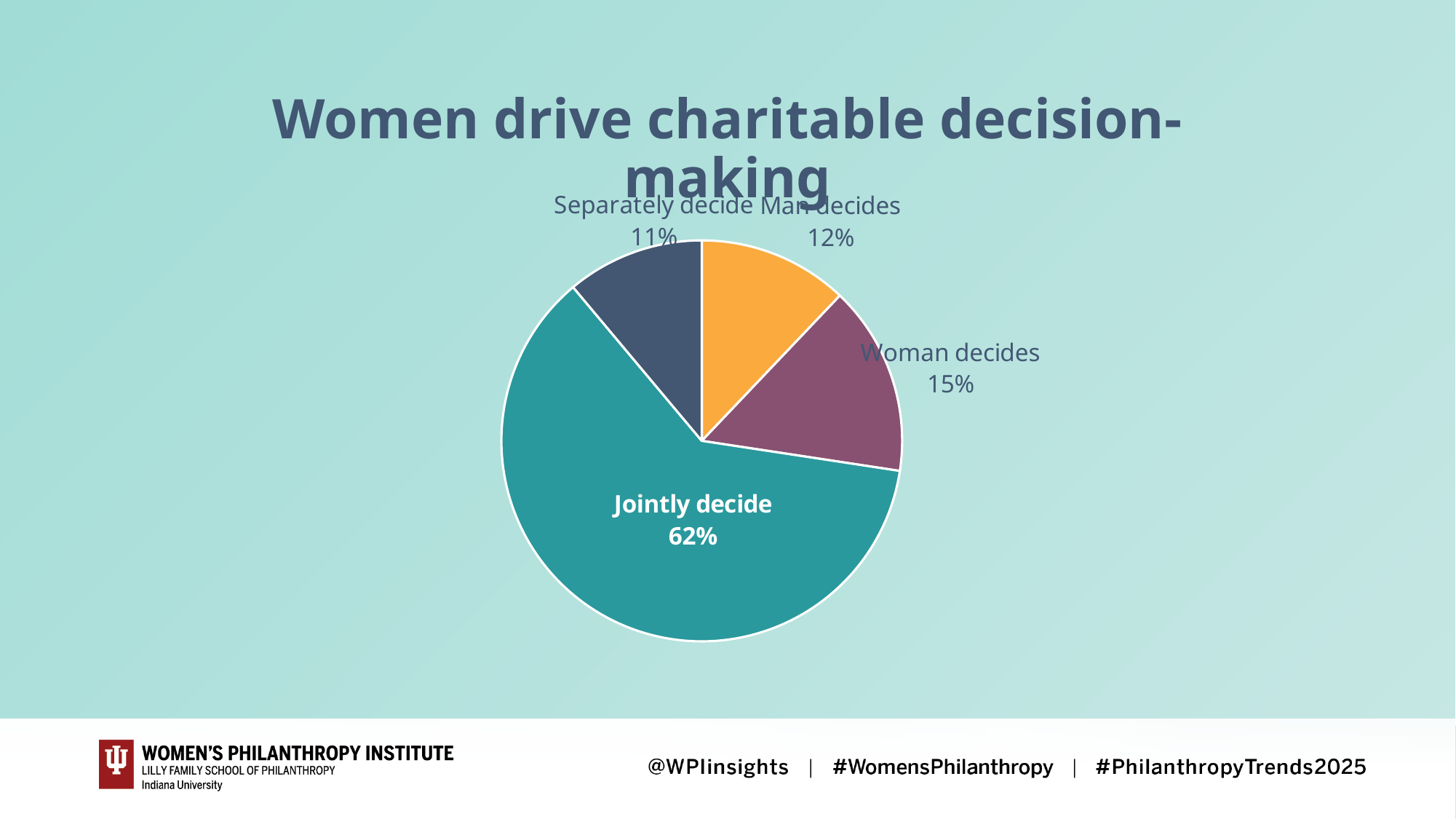
What percentage of the pie is labelled "Separately decide"? 11% Which is larger, the "Woman decides" slice or the "Man decides" slice? Woman decides What percentage of the pie is labelled "Man decides"? 12% Which slice of the pie is the largest? Jointly decide What kind of chart is shown on the slide? pie chart How many slices does the pie chart have? 4 What is the difference in percentage points between the "Jointly decide" slice and the "Woman decides" slice? 47 percentage points What percentage of the pie is labelled "Woman decides"? 15% What percentage of the pie is labelled "Jointly decide"? 62% What is the title of the slide containing the pie chart? Women drive charitable decision-making Which slice of the pie is the smallest? Separately decide What is the difference in percentage points between the "Woman decides" slice and the "Man decides" slice? 3 percentage points